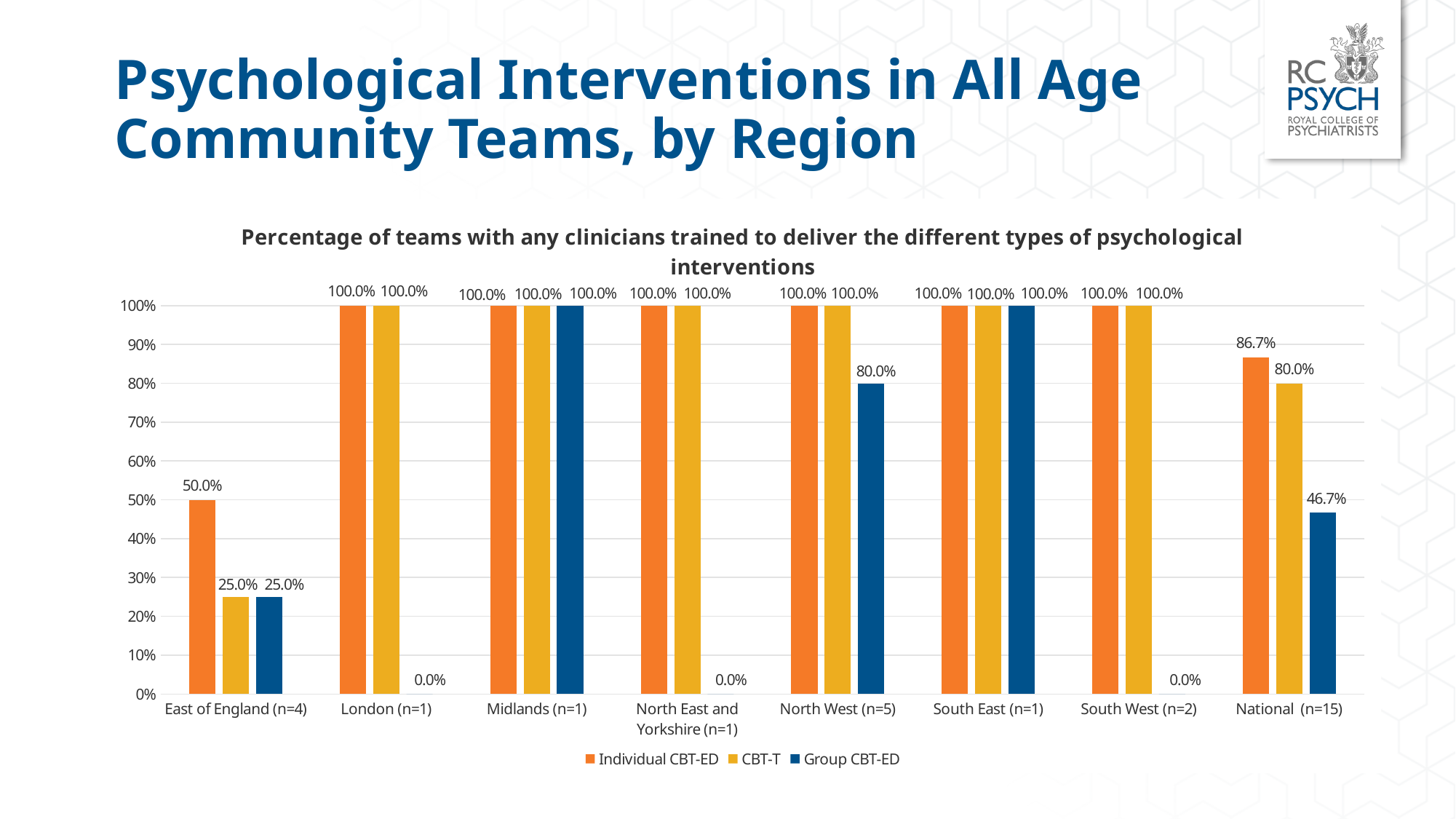
How many series does the legend list? 3 How many regions (categories) are shown on the x axis? 8 What is the value for Group CBT-ED in London (n=1)? 0.0% What is the difference between Individual CBT-ED and Group CBT-ED for National (n=15)? 40.0% What kind of chart is shown on the slide? Bar chart What is the value for Individual CBT-ED in East of England (n=4)? 50.0% Which region has the lowest value for Individual CBT-ED? East of England (n=4) What is the value for CBT-T in National (n=15)? 80.0% Which series is shown in dark blue in the legend? Group CBT-ED Which is larger in East of England (n=4): Individual CBT-ED or CBT-T? Individual CBT-ED What is the value for Group CBT-ED in North West (n=5)? 80.0% What is the value for Group CBT-ED in National (n=15)? 46.7%